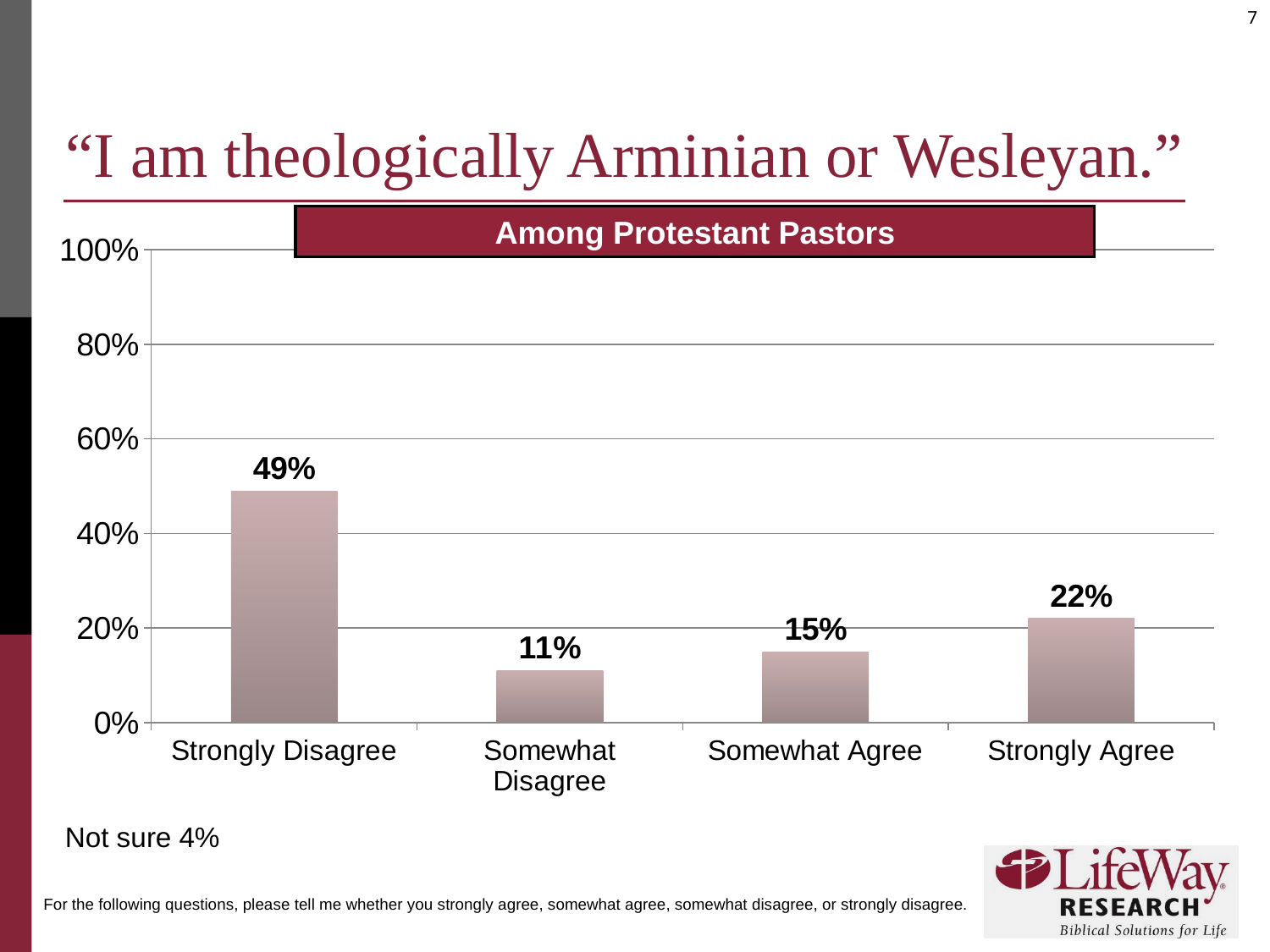
What percentage of Protestant pastors strongly disagree with the statement? 49% What group does the chart's subtitle say the results are among? Protestant Pastors Which is larger, the value for Somewhat Agree or the value for Strongly Agree? Strongly Agree What kind of chart is shown on the slide? Bar chart What is the difference between the Strongly Disagree and Strongly Agree values? 27% Which category has the lowest value? Somewhat Disagree What is the value for Somewhat Disagree? 11% Which category has the highest value? Strongly Disagree What is the value for Strongly Agree? 22% What is the value for Somewhat Agree? 15% How many categories are shown on the x axis of the chart? 4 Is the value for Strongly Disagree greater or less than 40%? greater